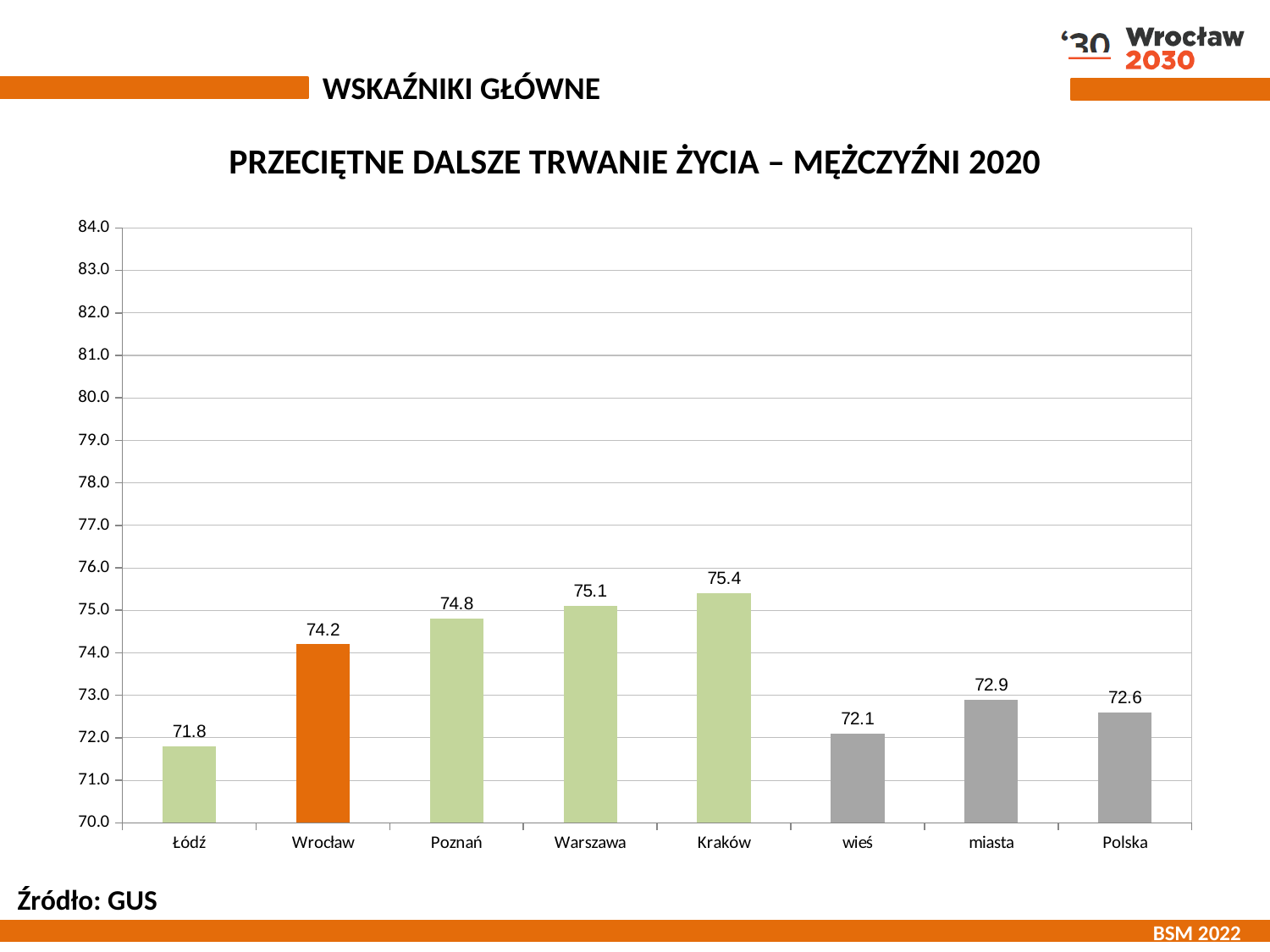
What is the value for Wrocław? 74.2 What is the value for wieś? 72.1 What kind of chart is shown on the slide? bar chart Which category has the lowest value? Łódź What is the value for Polska? 72.6 What is the title of the chart? PRZECIĘTNE DALSZE TRWANIE ŻYCIA – MĘŻCZYŹNI 2020 What is the difference between the values for Kraków and Łódź? 3.6 Which is larger, the value for Poznań or the value for miasta? Poznań What is the difference between the values for Warszawa and Wrocław? 0.9 What is the value for Kraków? 75.4 How many categories are shown on the x axis? 8 Which category has the highest value? Kraków